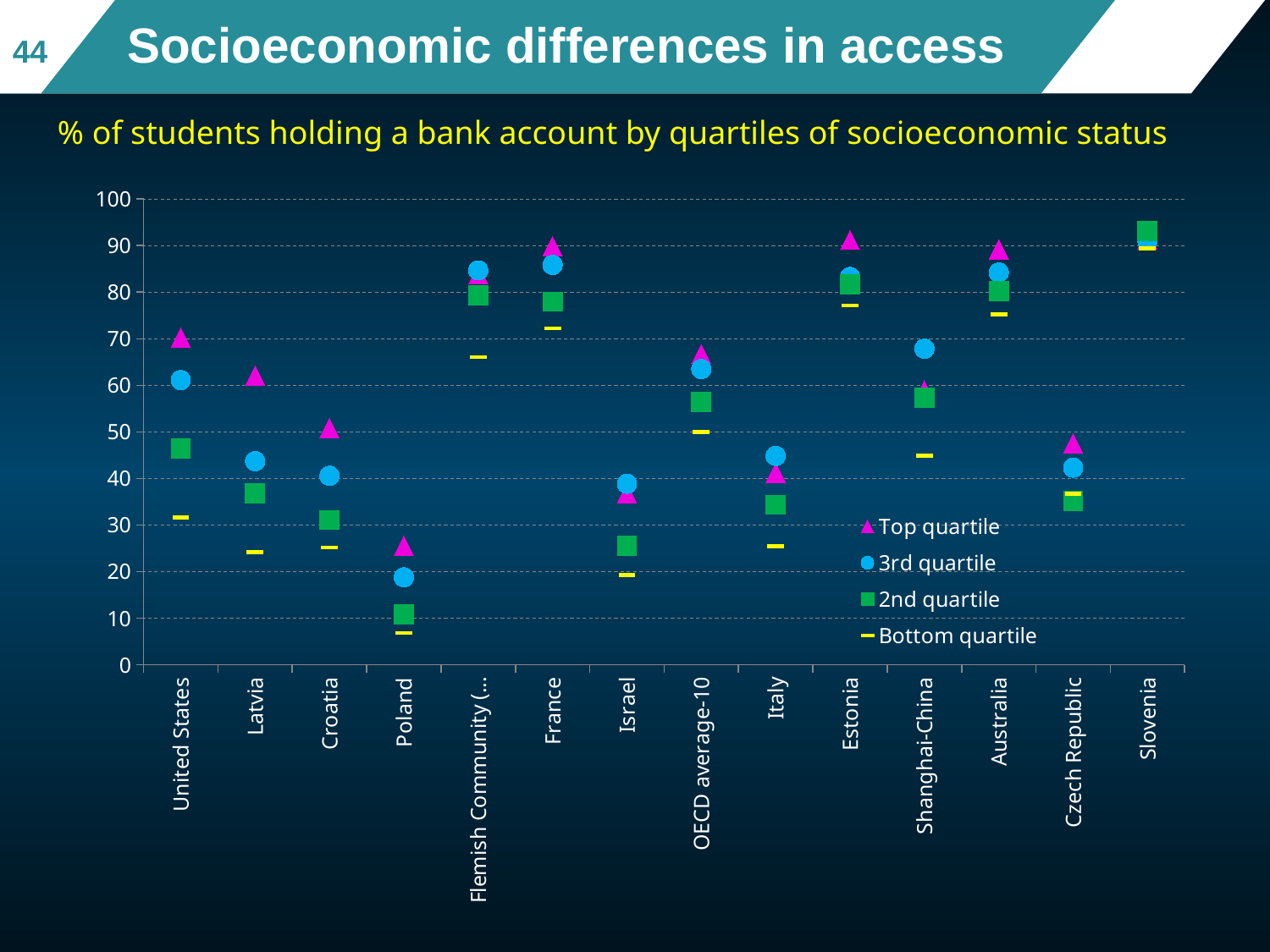
Which country has the lowest Bottom quartile value? Poland Is the 3rd quartile value for the United States greater or less than 50? greater What marker shape is used for the Top quartile series in the legend? Triangle Which is larger, the 2nd quartile value for Italy or for Estonia? Estonia How many series does the legend list? 4 Which country has the highest 3rd quartile value? Slovenia Is the 2nd quartile value for Slovenia greater or less than 90? greater How many countries or groups are shown along the x axis? 14 Is the 3rd quartile value for Shanghai-China greater or less than 60? greater